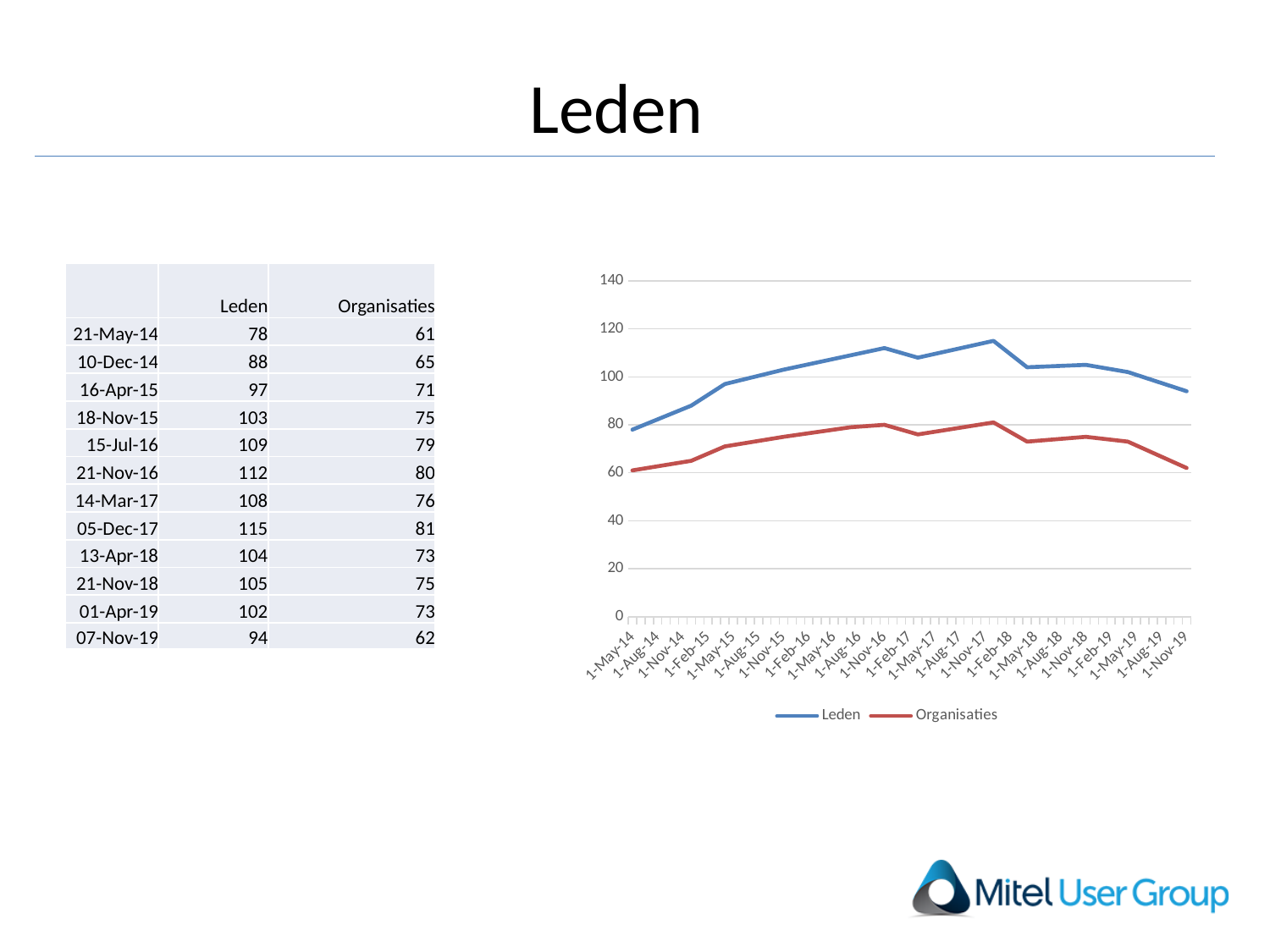
How many series does the chart legend list? 2 Which series is drawn in blue on the chart? Leden On which date is the Organisaties series at its lowest value? 21-May-14 What are the two series named in the chart legend? Leden and Organisaties According to the table on the slide, what is the Organisaties value on 21-Nov-16? 80 How many data points does the table list for each series? 12 What is the difference between the Leden and Organisaties values on 07-Nov-19? 32 Is the Leden value at the last point of the chart (1-Nov-19) greater or less than 100? less On which date does the Leden series reach its highest value? 05-Dec-17 Which series has the higher values throughout the chart, Leden or Organisaties? Leden According to the table on the slide, what is the Leden value on 05-Dec-17? 115 What kind of chart is shown on the slide? line chart